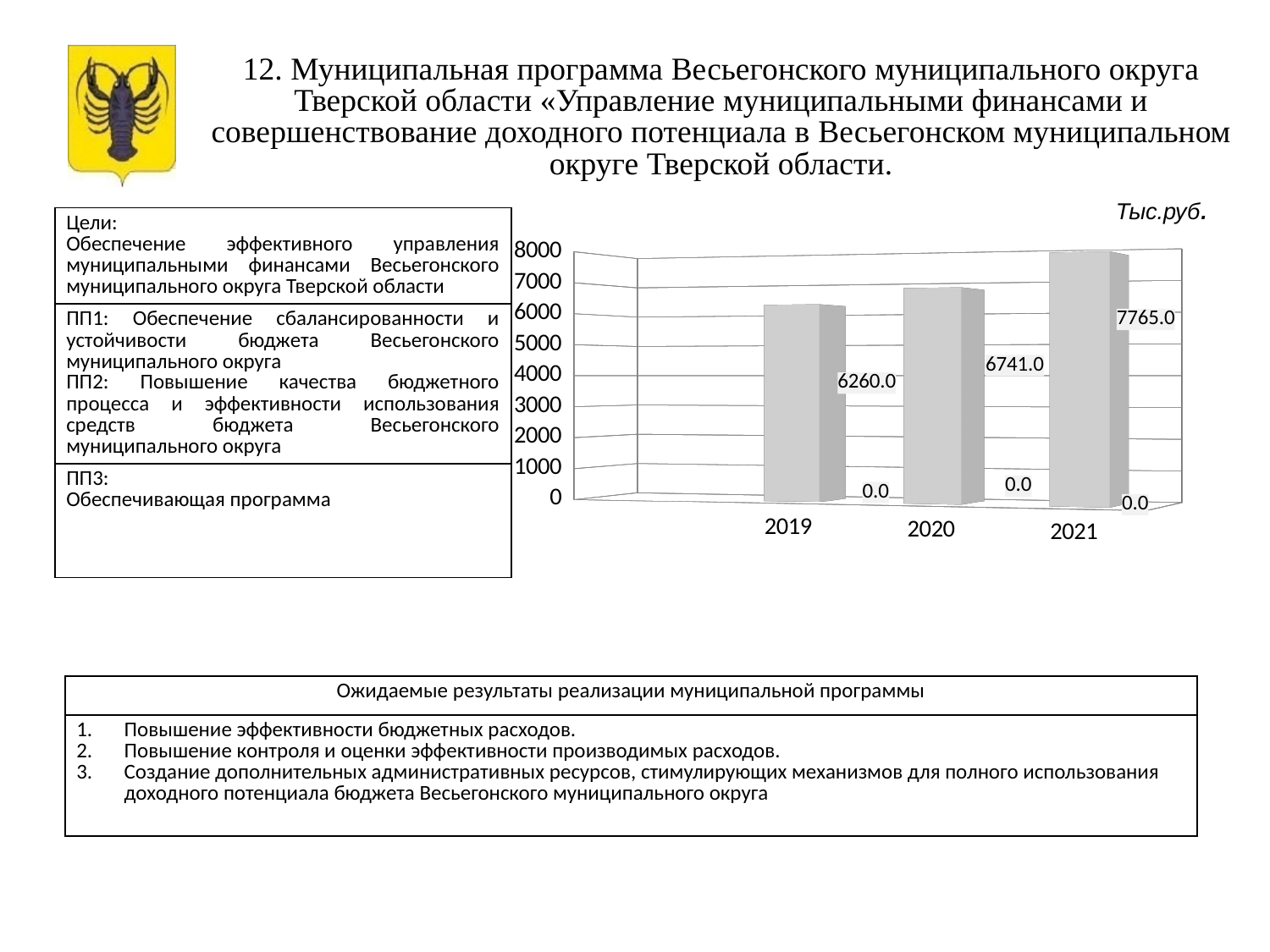
Which year has the lowest non-zero value? 2019 What is the value shown for 2020? 6741.0 What is the value shown for 2021? 7765.0 Which is larger, the value for 2020 or the value for 2021? 2021 Is the value for 2021 greater or less than 7000? greater Which year has the highest value? 2021 What kind of chart is shown? bar chart What is the difference between the values for 2020 and 2019? 481.0 What is the value shown for 2019? 6260.0 Do the values rise or fall from 2019 to 2021? rise What is the difference between the values for 2021 and 2019? 1505.0 How many years are shown on the x axis? 3